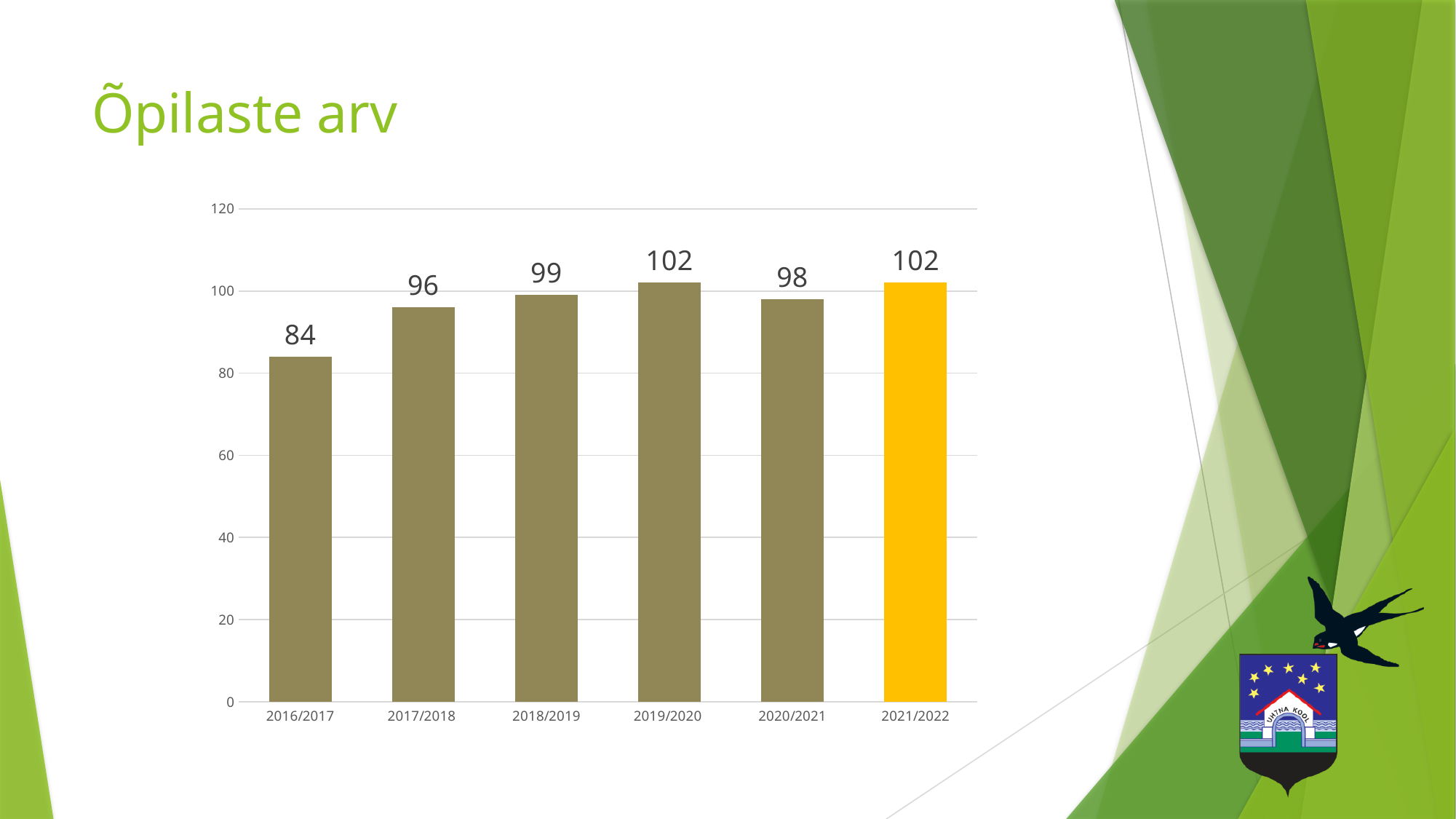
Which bar is coloured differently (yellow) from the others? 2021/2022 How many school years are shown on the x axis? 6 What is the difference between the values for 2017/2018 and 2016/2017? 12 Is the value for 2016/2017 greater or less than 100? less Which is larger, the value for 2018/2019 or the value for 2020/2021? 2018/2019 Which school year has the lowest value? 2016/2017 What is the difference between the values for 2019/2020 and 2020/2021? 4 Does the value rise or fall from 2016/2017 to 2019/2020? rise What is the value for 2016/2017? 84 What is the value for 2018/2019? 99 What kind of chart is shown on the slide? bar chart What is the value for 2020/2021? 98